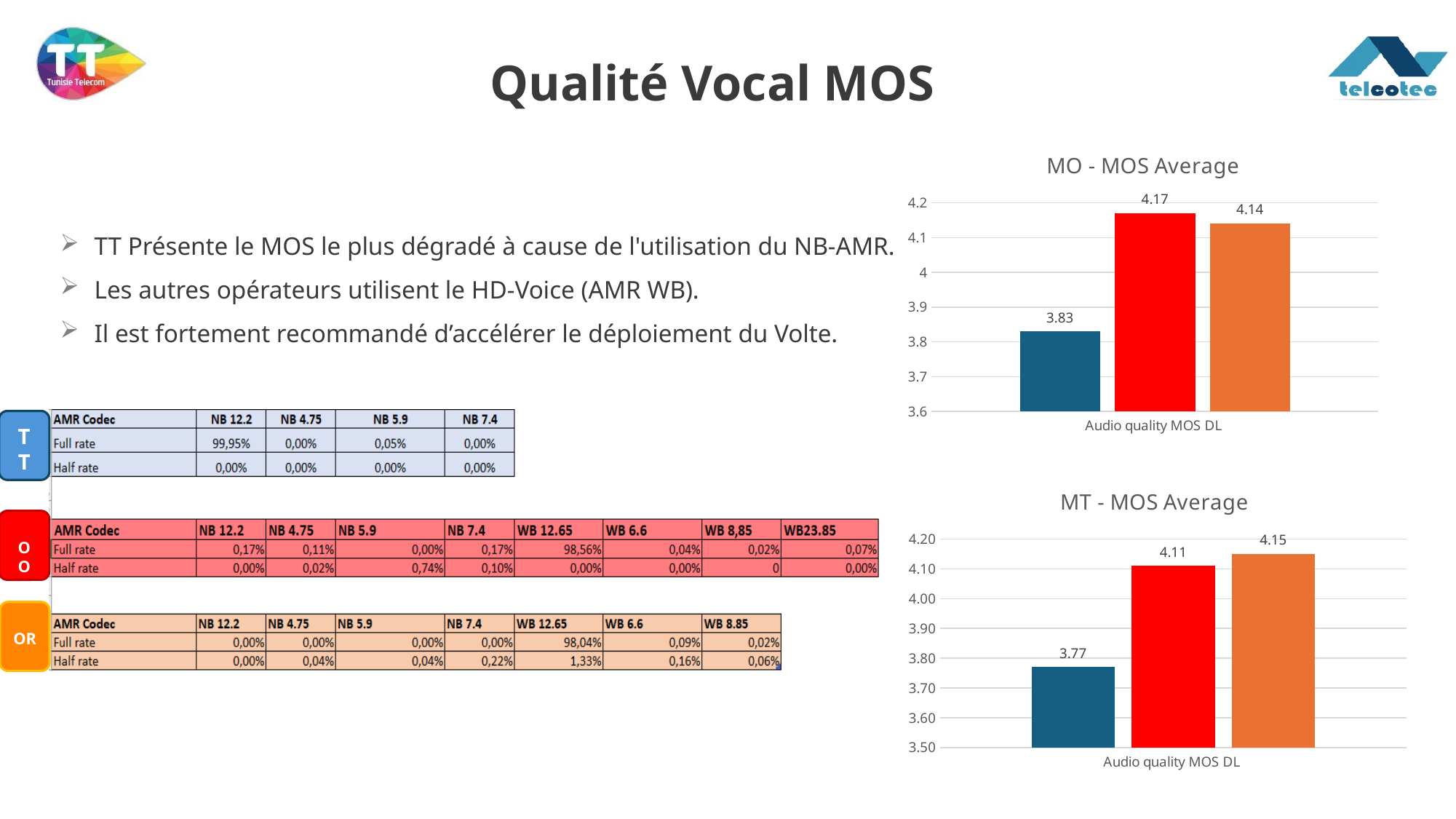
In the MT - MOS Average chart, which bar has the lowest value? the blue bar (3.77) In the MO - MOS Average chart, what is the value of the red bar? 4.17 What type of chart is the MO - MOS Average chart? bar chart In the MT - MOS Average chart, what is the value of the orange bar? 4.15 In the MO - MOS Average chart, is the value of the blue bar greater or less than 4? less In the MO - MOS Average chart, what is the value of the blue bar? 3.83 How many bars are plotted in the MT - MOS Average chart? 3 In the MT - MOS Average chart, which is larger, the red bar or the orange bar? the orange bar In the MO - MOS Average chart, what is the difference between the red bar and the blue bar? 0.34 In the MO - MOS Average chart, which bar has the highest value? the red bar (4.17) In the MT - MOS Average chart, what is the value of the blue bar? 3.77 In the MT - MOS Average chart, what is the difference between the orange bar and the red bar? 0.04